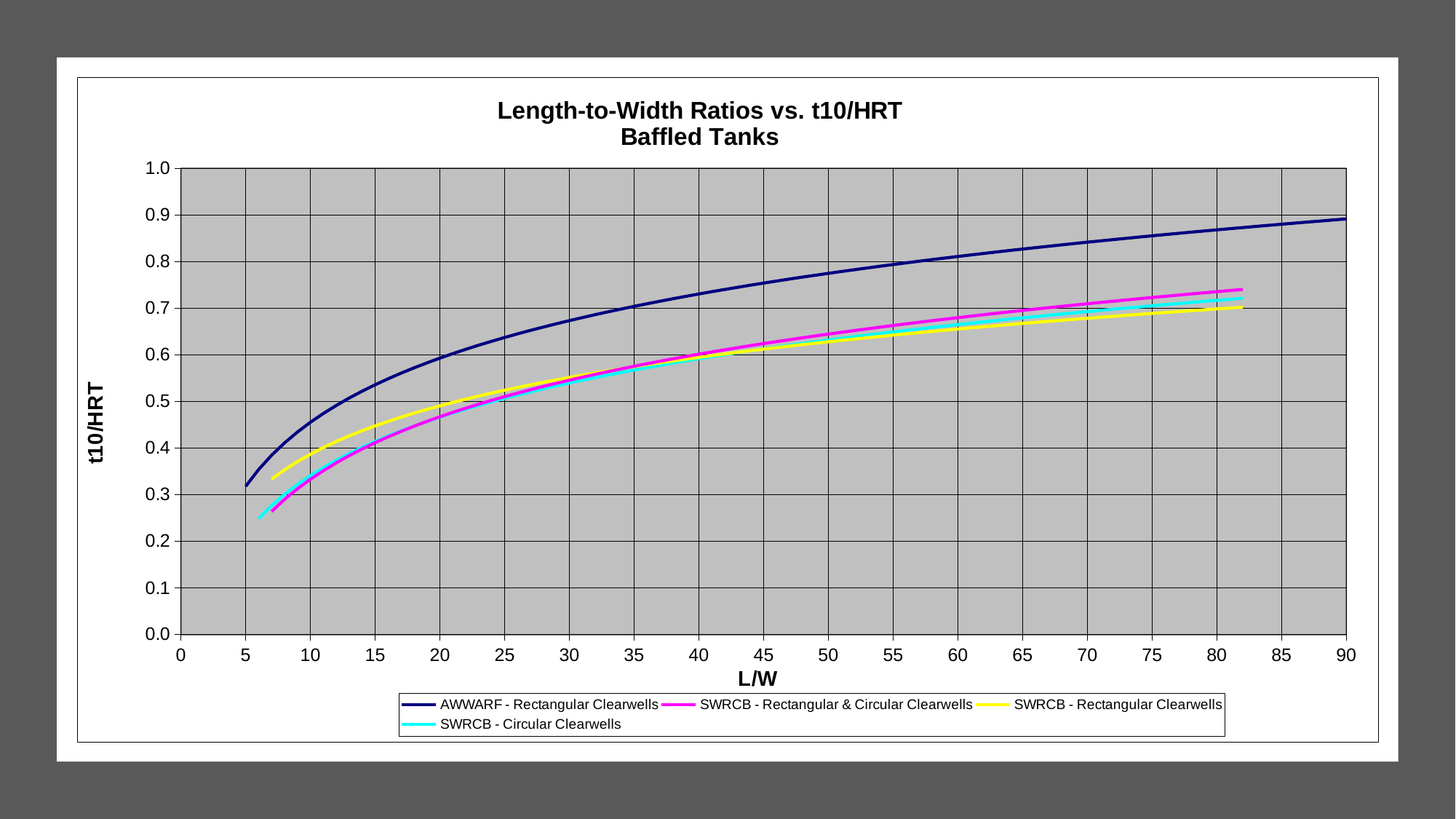
Is the t10/HRT value for AWWARF - Rectangular Clearwells at L/W = 5 greater or less than 0.4? less How many series does the legend list? 4 Is the t10/HRT value for AWWARF - Rectangular Clearwells at L/W = 70 greater or less than 0.8? greater What is the label of the y axis? t10/HRT At L/W = 30, which series has the larger t10/HRT: AWWARF - Rectangular Clearwells or SWRCB - Rectangular Clearwells? AWWARF - Rectangular Clearwells Which series has the highest t10/HRT at L/W = 50? AWWARF - Rectangular Clearwells Is the t10/HRT value for AWWARF - Rectangular Clearwells at L/W = 40 greater or less than 0.7? greater What is the title of the chart? Length-to-Width Ratios vs. t10/HRT Baffled Tanks Do the t10/HRT values for the AWWARF - Rectangular Clearwells series rise or fall as L/W increases? Rise What kind of chart is shown on the slide? Line chart